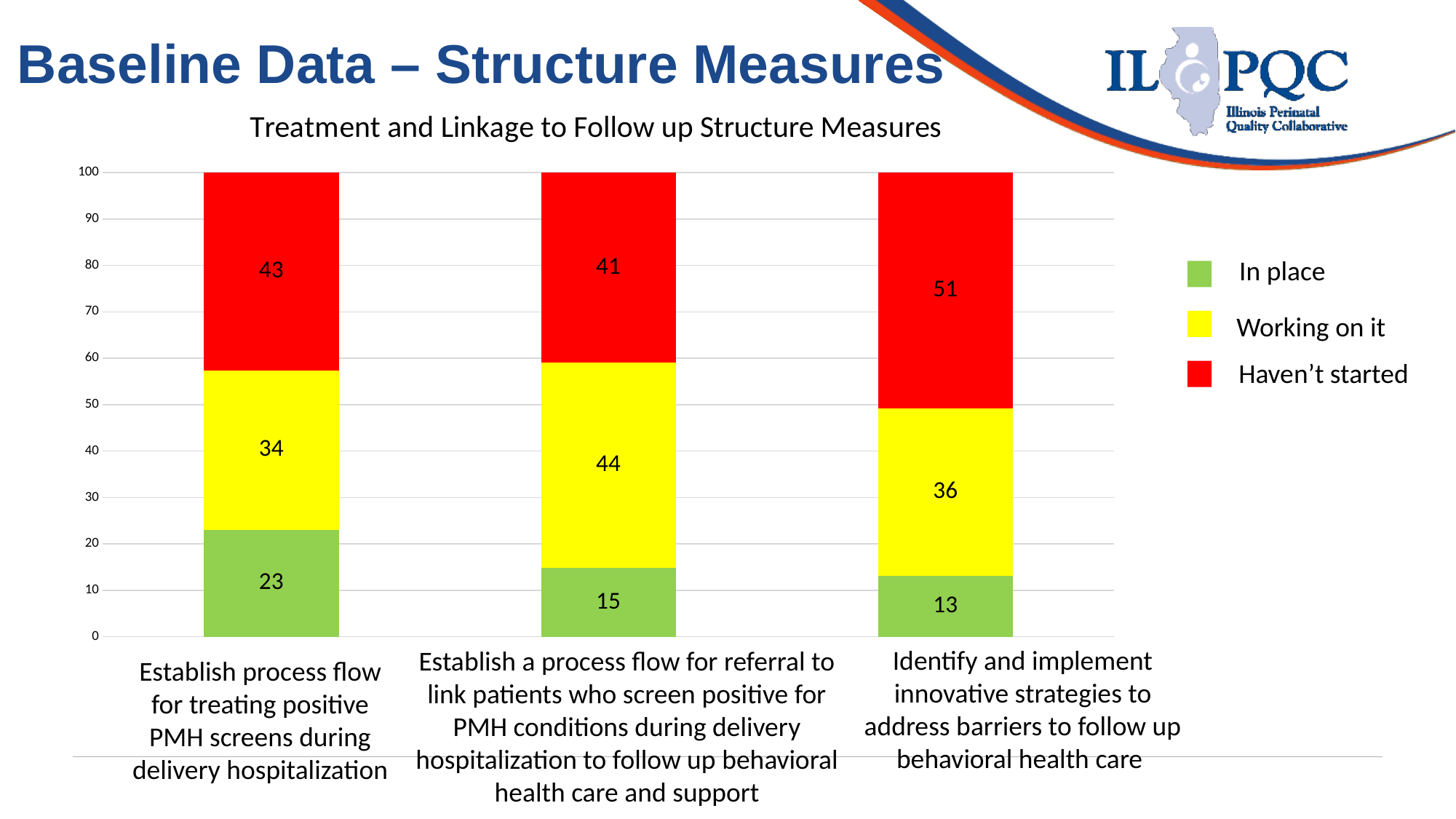
What is the 'In place' value for 'Establish process flow for treating positive PMH screens during delivery hospitalization'? 23 Which category has the highest 'In place' value? Establish process flow for treating positive PMH screens during delivery hospitalization What is the 'Working on it' value for 'Establish a process flow for referral to link patients who screen positive for PMH conditions during delivery hospitalization to follow up behavioral health care and support'? 44 What is the total of the stacked bar for 'Establish process flow for treating positive PMH screens during delivery hospitalization'? 100 What is the difference between the 'Haven't started' values for 'Identify and implement innovative strategies to address barriers to follow up behavioral health care' and 'Establish process flow for treating positive PMH screens during delivery hospitalization'? 8 Which category has the lowest 'In place' value? Identify and implement innovative strategies to address barriers to follow up behavioral health care How many series does the legend list? 3 Which is larger for the middle bar ('Establish a process flow for referral...'): the 'Working on it' value or the 'Haven't started' value? Working on it What kind of chart is shown on the slide? Stacked bar chart What is the 'Haven't started' value for 'Identify and implement innovative strategies to address barriers to follow up behavioral health care'? 51 How many categories (bars) are shown in the chart? 3 What is the title of the chart? Treatment and Linkage to Follow up Structure Measures